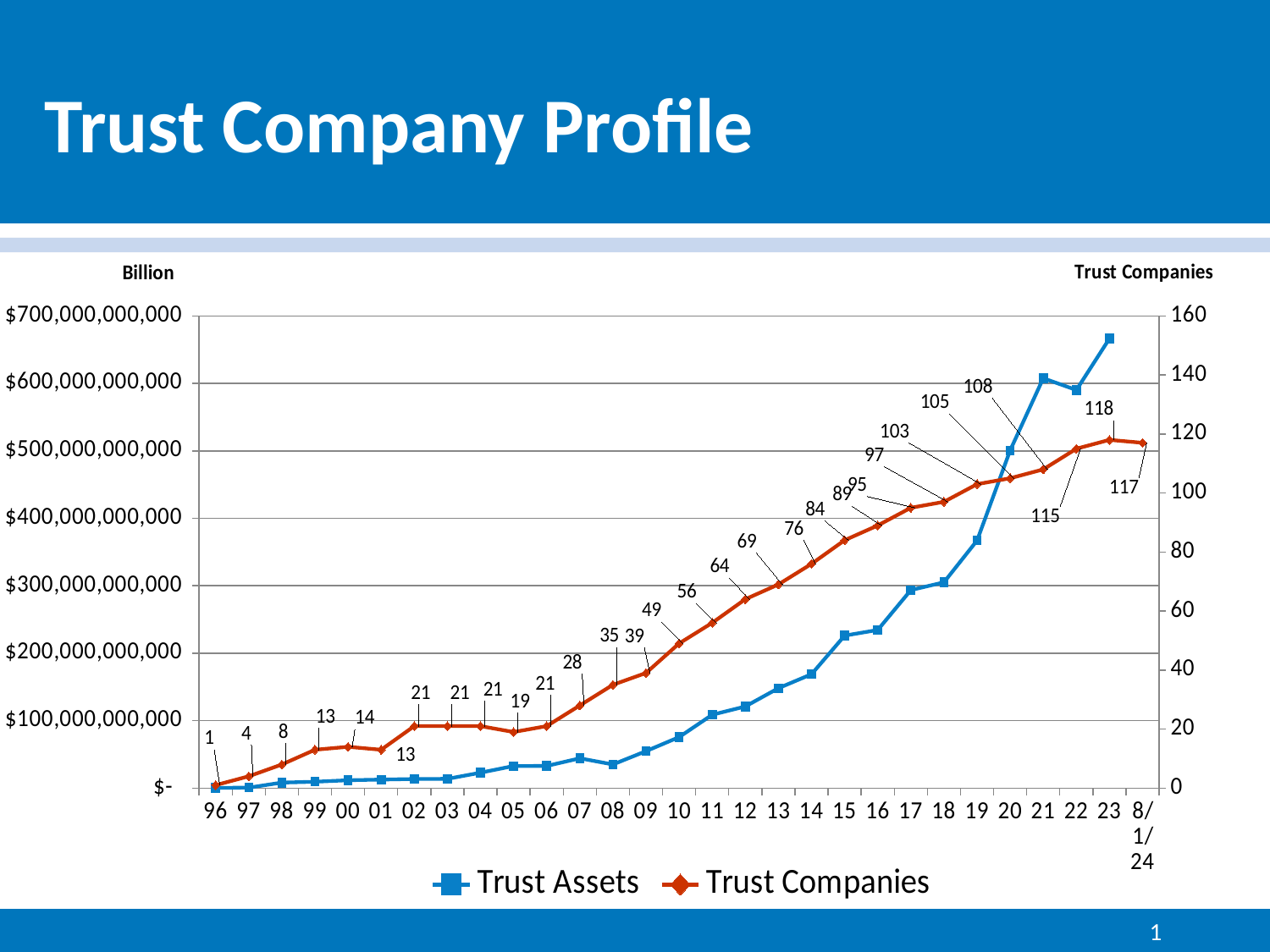
Which is larger, the Trust Companies value in 05 or in 06? 06 Is the Trust Assets value in 23 greater or less than $600,000,000,000? greater What is the difference between the Trust Companies values in 23 and 8/1/24? 1 What is the value of Trust Companies at 8/1/24? 117 What is the value of Trust Companies in 23? 118 What kind of chart is shown on the slide? line chart In which year does Trust Companies reach its highest value? 23 How many series does the legend list? 2 What is the value of Trust Companies in 96? 1 What is the value of Trust Companies in 12? 64 Is the Trust Assets value in 10 greater or less than $100,000,000,000? less